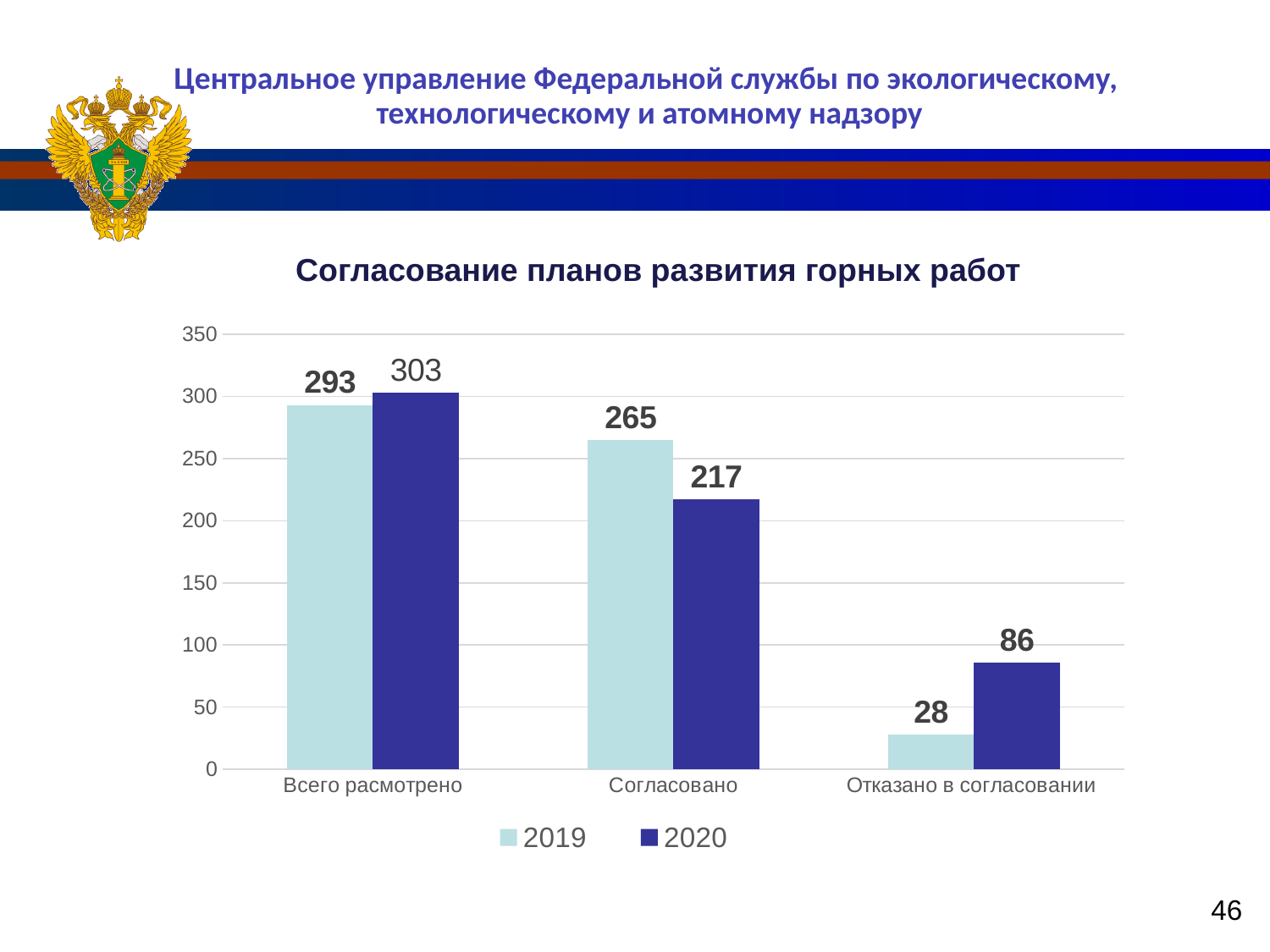
What is the value for 2020 in the 'Согласовано' category? 217 Is the 2020 value for 'Отказано в согласовании' greater or less than 100? less What is the value for 2019 in the 'Всего расмотрено' category? 293 How many series does the legend list? 2 Which category has the highest value for the 2020 series? Всего расмотрено What type of chart is shown on the slide? bar chart What is the difference between the 2020 and 2019 values in the 'Отказано в согласовании' category? 58 What is the value for 2019 in the 'Отказано в согласовании' category? 28 What is the difference between the 2019 and 2020 values in the 'Согласовано' category? 48 How many categories are shown on the x axis? 3 Which category has the lowest value for the 2019 series? Отказано в согласовании Which is larger in the 'Всего расмотрено' category: the 2019 value or the 2020 value? 2020